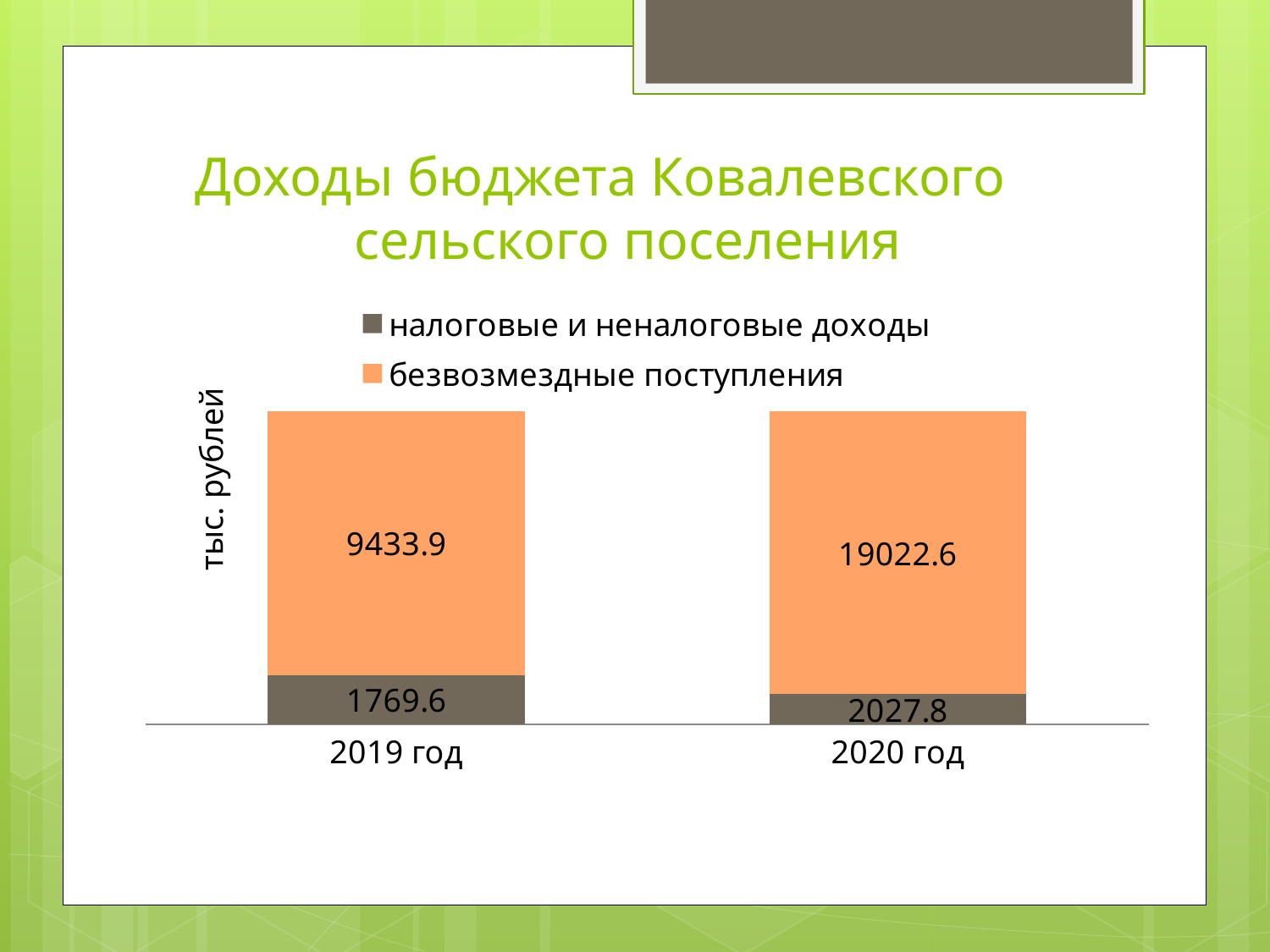
Which year has the higher value for безвозмездные поступления? 2020 год What is the total of the two labelled values for 2019 год? 11203.5 What is the total of the two labelled values for 2020 год? 21050.4 What unit is shown on the vertical axis label? тыс. рублей Which year has the lower value for налоговые и неналоговые доходы? 2019 год How many series does the legend list? 2 What is the value of налоговые и неналоговые доходы for 2019 год? 1769.6 What is the value of безвозмездные поступления for 2019 год? 9433.9 What is the value of безвозмездные поступления for 2020 год? 19022.6 By how much did безвозмездные поступления increase from 2019 год to 2020 год? 9588.7 What is the difference between налоговые и неналоговые доходы in 2020 год and 2019 год? 258.2 What is the value of налоговые и неналоговые доходы for 2020 год? 2027.8